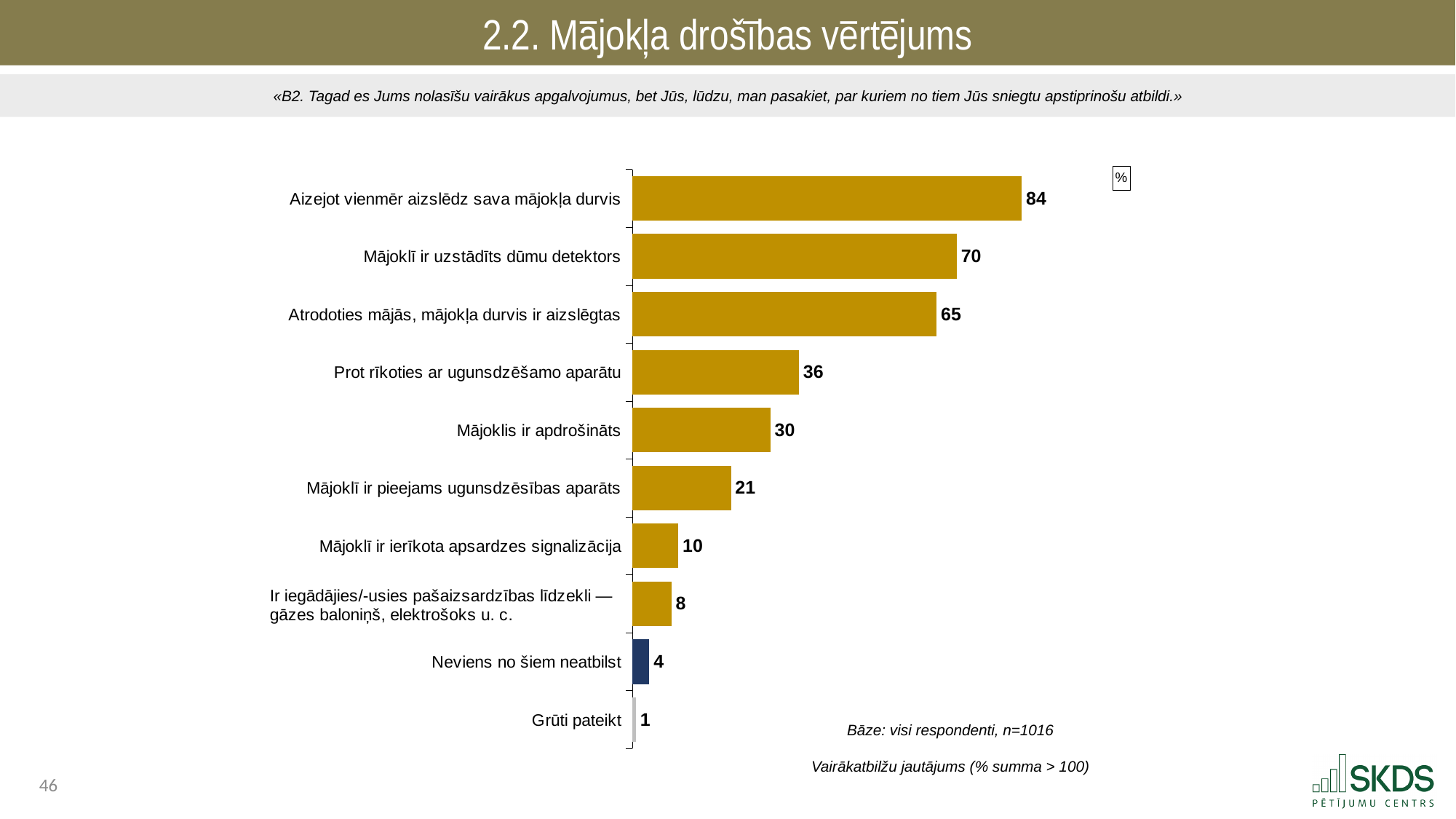
Which category has the lowest value? Grūti pateikt What is the difference between the values for "Mājoklis ir apdrošināts" and "Mājoklī ir pieejams ugunsdzēsības aparāts"? 9 What is the value for "Mājoklī ir ierīkota apsardzes signalizācija"? 10 Which is larger: the value for "Mājoklis ir apdrošināts" or the value for "Prot rīkoties ar ugunsdzēšamo aparātu"? Prot rīkoties ar ugunsdzēšamo aparātu What kind of chart is shown on the slide? Bar chart What is the difference between the values for "Aizejot vienmēr aizslēdz sava mājokļa durvis" and "Atrodoties mājās, mājokļa durvis ir aizslēgtas"? 19 What is the value for "Neviens no šiem neatbilst"? 4 What is the value for "Prot rīkoties ar ugunsdzēšamo aparātu"? 36 How many categories are shown in the chart? 10 Which category has the highest value? Aizejot vienmēr aizslēdz sava mājokļa durvis What is the value for "Mājoklī ir uzstādīts dūmu detektors"? 70 What is the base (n) of respondents stated below the chart? n=1016